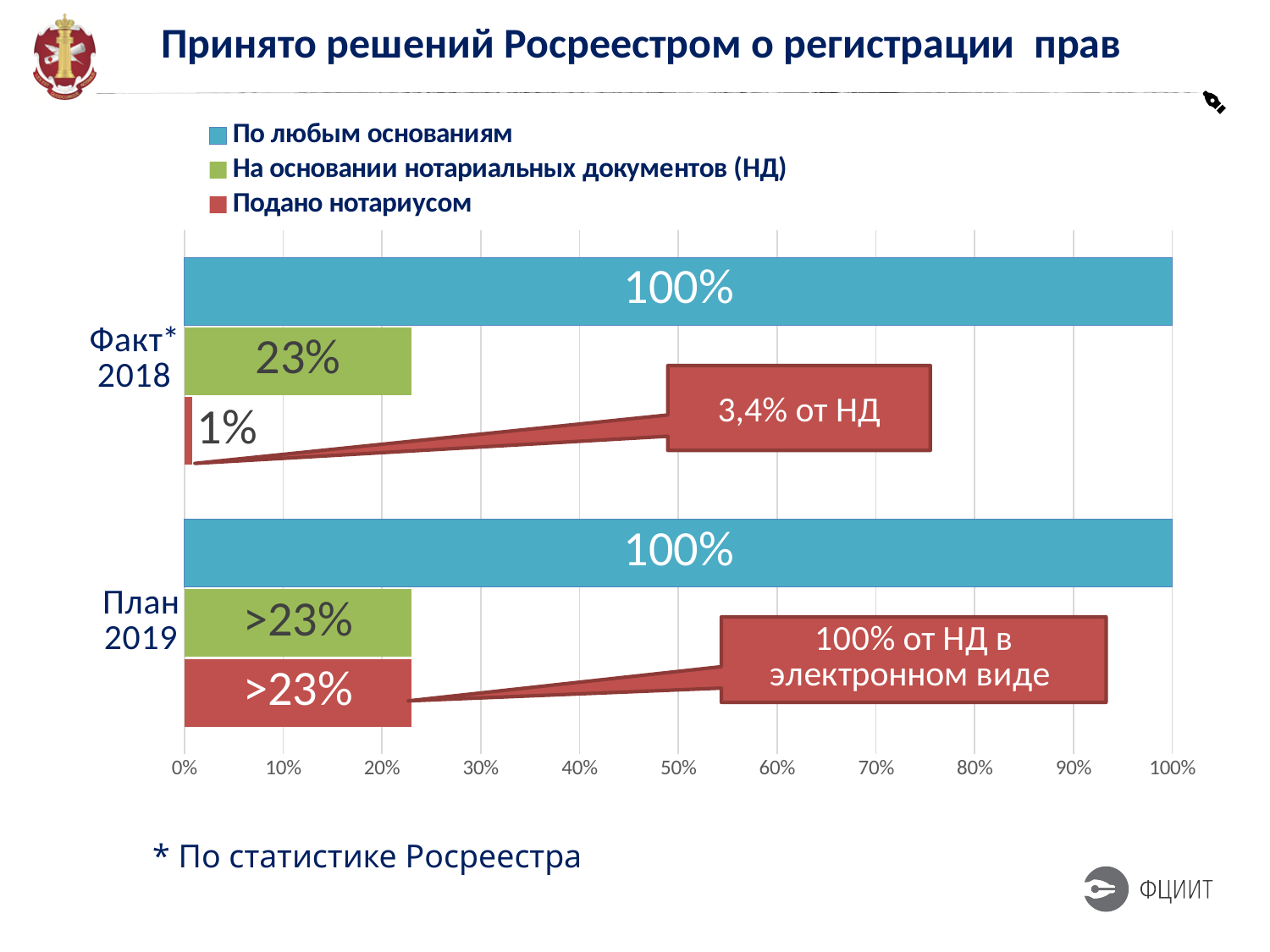
What is the title of the chart? Принято решений Росреестром о регистрации прав Which series has the lowest value for Факт* 2018? Подано нотариусом Is the value for "На основании нотариальных документов (НД)" for Факт* 2018 greater or less than 30%? less What is the data label for "Подано нотариусом" for План 2019? >23% What kind of chart is shown on the slide? bar chart How many series does the legend list? 3 How many categories are shown on the chart? 2 What is the difference between "По любым основаниям" and "На основании нотариальных документов (НД)" for Факт* 2018? 77% Which series has the highest value for Факт* 2018? По любым основаниям What is the value for "По любым основаниям" for План 2019? 100% What is the value for "На основании нотариальных документов (НД)" for Факт* 2018? 23% What is the value for "Подано нотариусом" for Факт* 2018? 1%